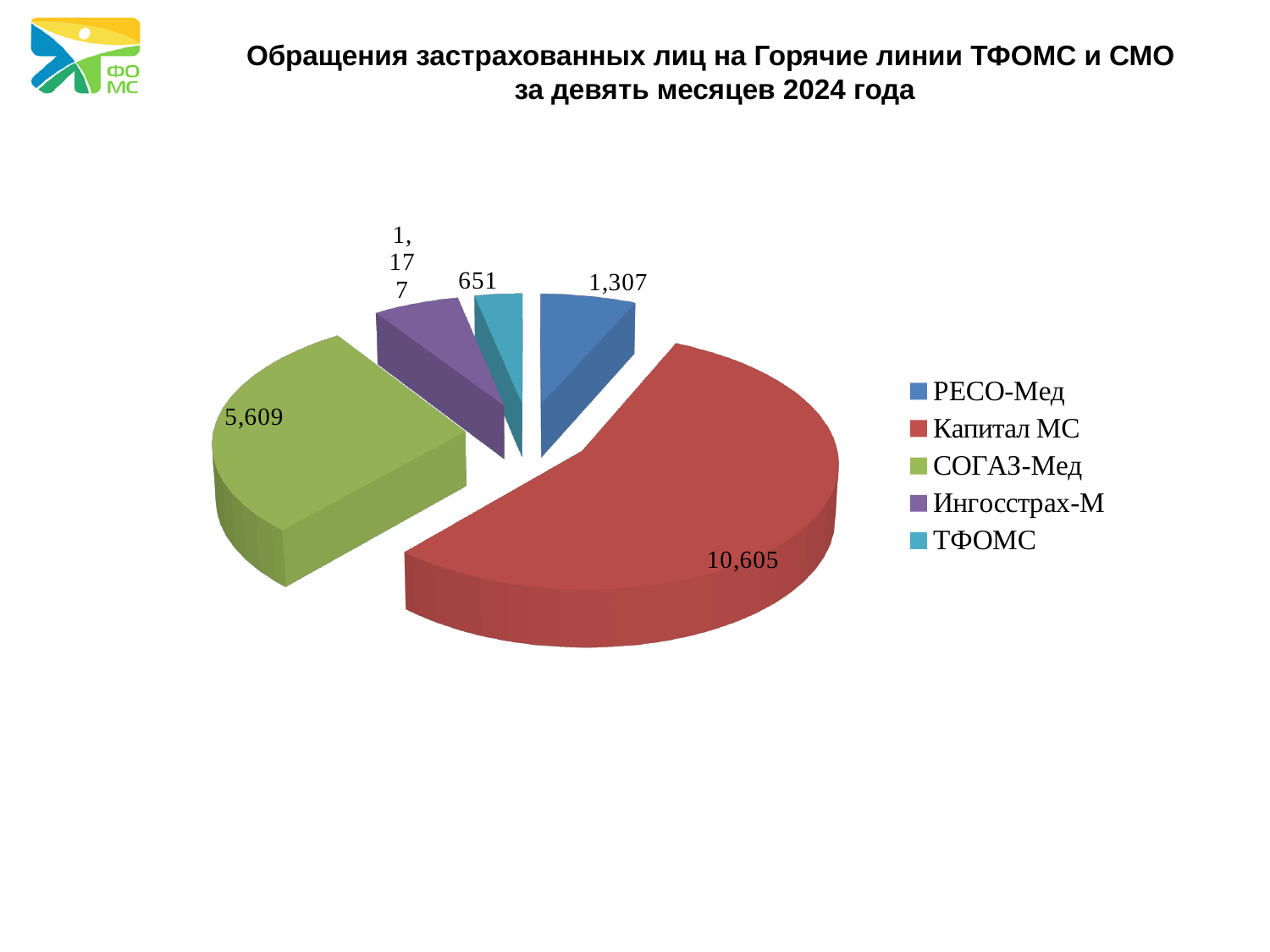
How many entries does the legend list? 5 Which category has the largest slice? Капитал МС What kind of chart is shown on the slide? Pie chart Which is larger, the value for РЕСО-Мед or the value for ТФОМС? РЕСО-Мед What is the value for ТФОМС? 651 Which category has the smallest slice? ТФОМС What is the difference between the values for Капитал МС and СОГАЗ-Мед? 4,996 How many slices does the pie chart have? 5 What is the value for Капитал МС? 10,605 What is the value for РЕСО-Мед? 1,307 What is the value for СОГАЗ-Мед? 5,609 Which colour represents СОГАЗ-Мед in the legend? Green